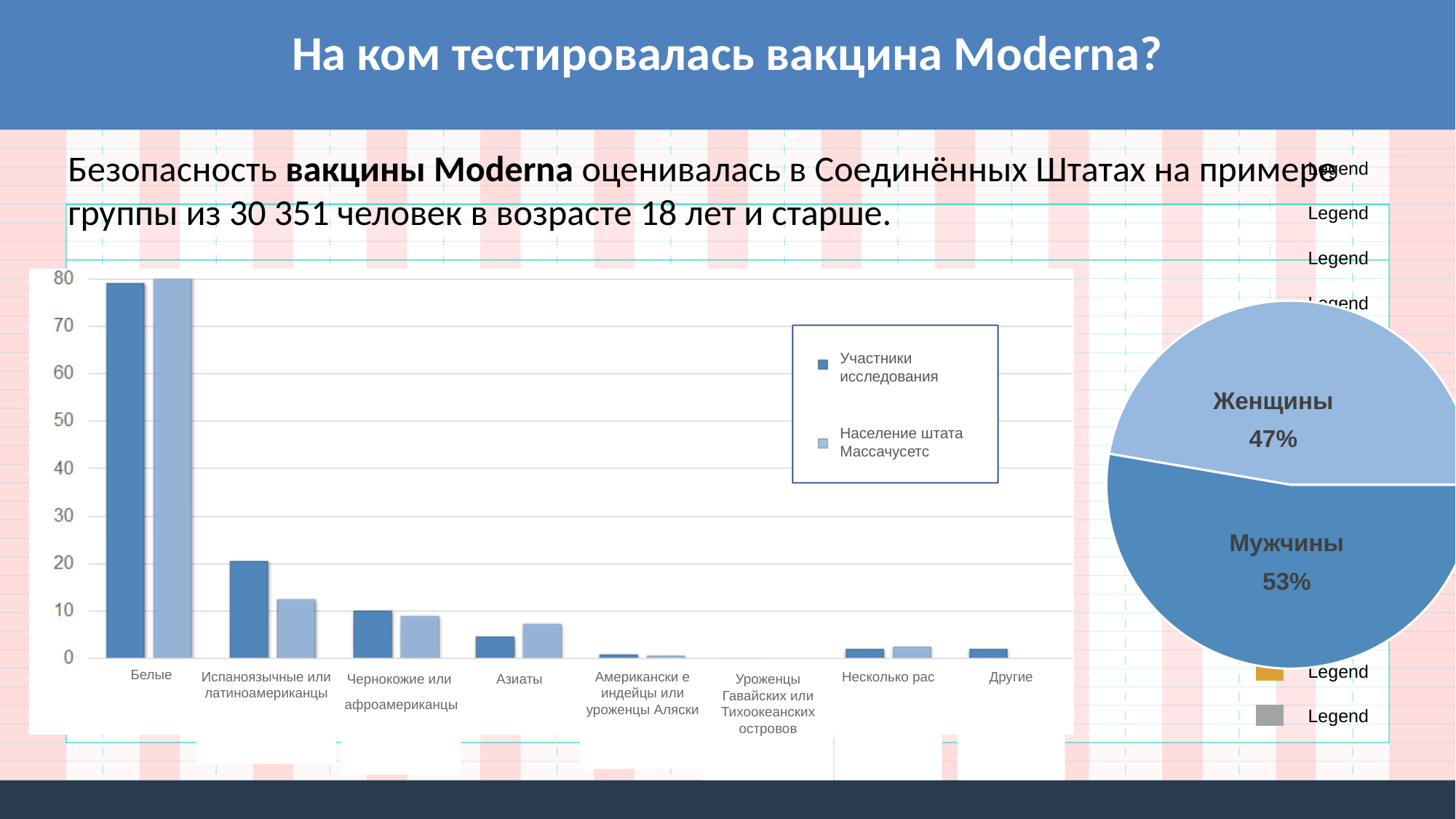
How many categories are shown on the x axis of the bar chart? 8 On the pie chart, which slice is larger, Мужчины or Женщины? Мужчины In the bar chart, which category has the highest value for Участники исследования? Белые In the bar chart, is the value for Белые in the Участники исследования series greater or less than 70? greater In the bar chart, for Азиаты, which series has the larger value, Участники исследования or Население штата Массачусетс? Население штата Массачусетс What kind of chart is the chart on the left side of the slide? Bar chart In the bar chart, for Испаноязычные или латиноамериканцы, which series has the larger value, Участники исследования or Население штата Массачусетс? Участники исследования On the pie chart, what share is labelled for Женщины? 47% On the pie chart, what share is labelled for Мужчины? 53% On the pie chart, by how many percentage points does the Мужчины share exceed the Женщины share? 6 percentage points How many series does the legend of the bar chart list? 2 How many slices does the pie chart on the right have? 2